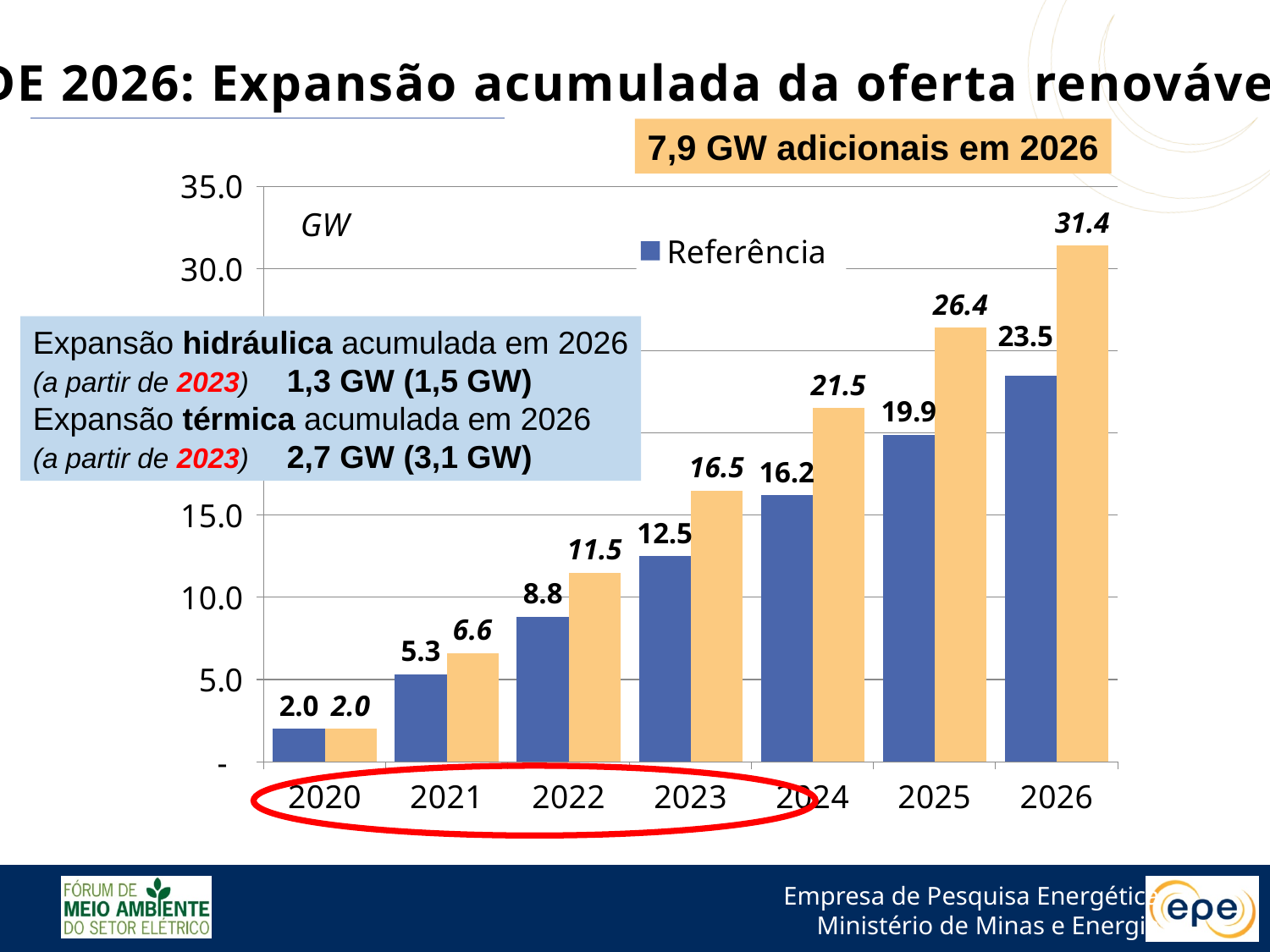
In which year is the orange series lowest? 2020 Do the Referência values rise or fall from 2020 to 2026? rise What kind of chart is shown on the slide? bar chart What is the value of the Referência series for 2023? 12.5 By how much does the Referência value increase from 2021 to 2022? 3.5 How many years are shown on the x axis? 7 What series name is shown in the chart legend? Referência What is the value of the Referência series for 2026? 23.5 In which year is the Referência series highest? 2026 What is the difference between the orange bar and the Referência bar in 2026? 7.9 In 2024, which is larger: the Referência bar or the orange bar? the orange bar What is the value of the orange bar for 2025? 26.4